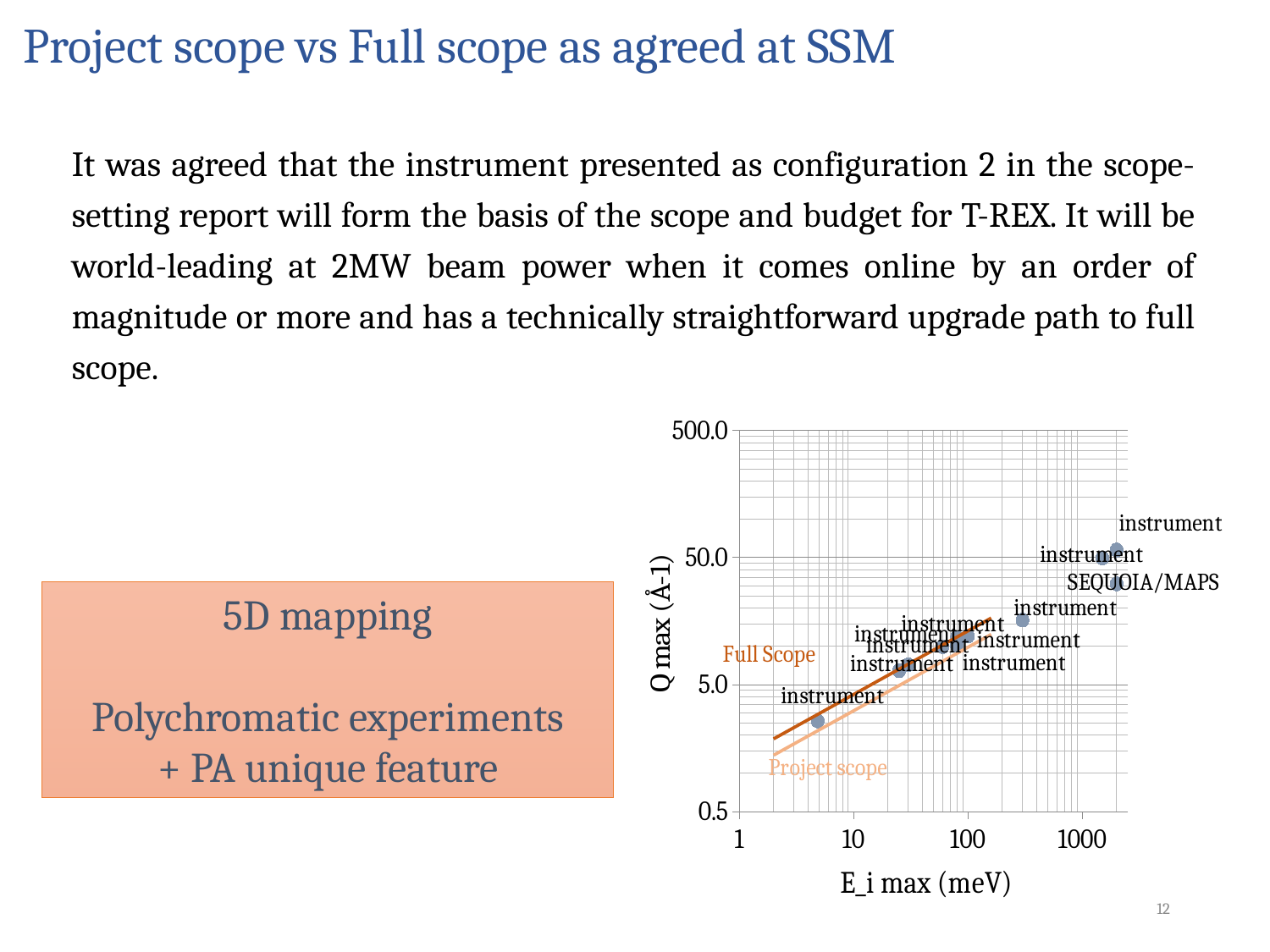
Is the Q max value for the SEQUOIA/MAPS point greater or less than 5.0? greater Is the Q max value of the lowest plotted point greater or less than 5.0? less Do the plotted Q max values rise or fall as E_i max increases along the x axis? rise What is the lowest tick value shown on the y axis of the chart? 0.5 Is the Q max value for the SEQUOIA/MAPS point greater or less than 50.0? less What is the title of the x axis of the chart? E_i max (meV) What kind of chart is shown on the slide? scatter chart What is the highest tick value shown on the y axis of the chart? 500.0 What is the highest tick value shown on the x axis of the chart? 1000 Which of the two lines lies higher on the chart, Full Scope or Project scope? Full Scope What is the title of the y axis of the chart? Q max (Å-1)